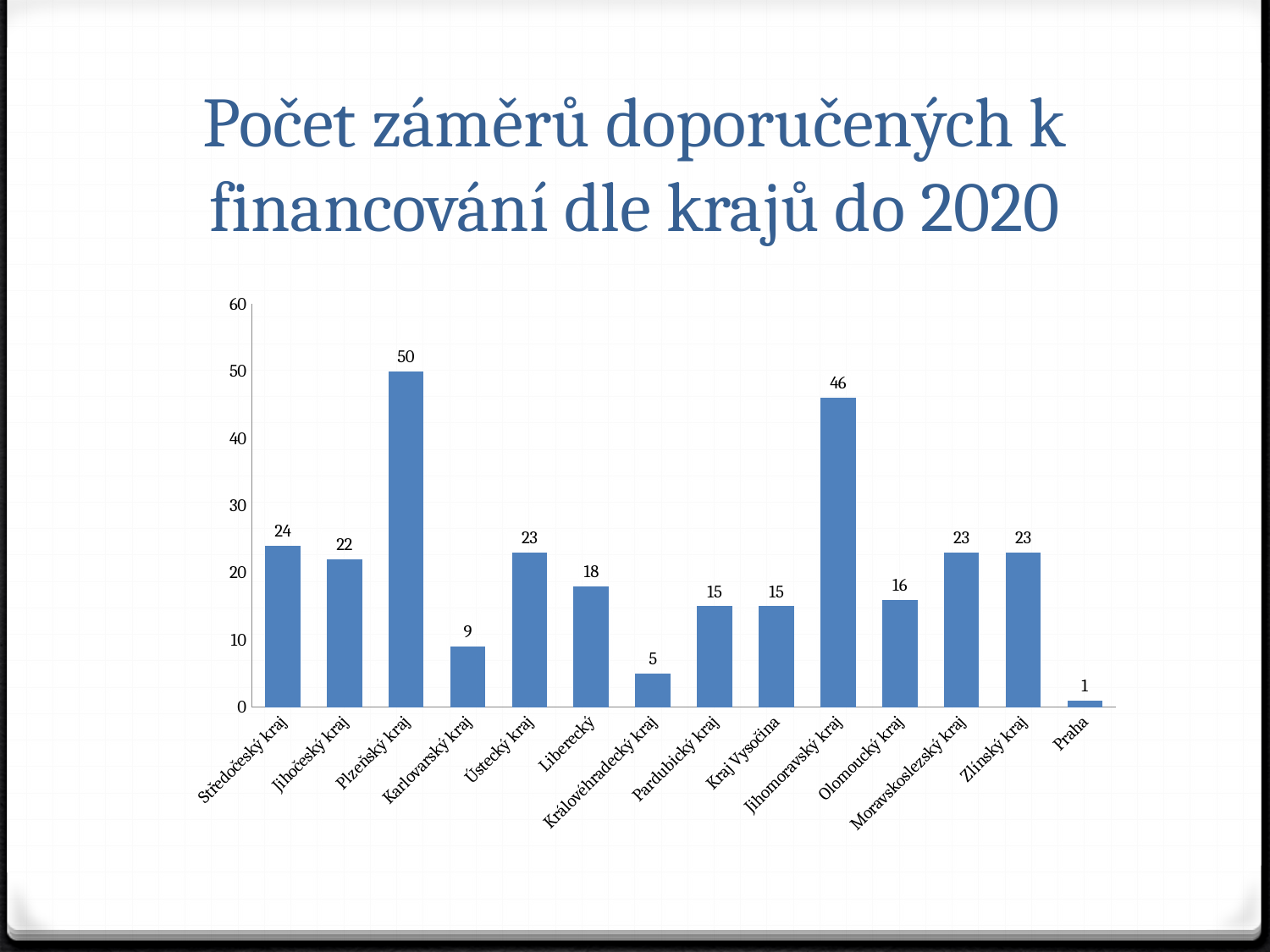
What is the value for Karlovarský kraj? 9 What is the difference between the values for Královéhradecký kraj and Praha? 4 What is the difference between the values for Plzeňský kraj and Jihomoravský kraj? 4 What is the value for Jihomoravský kraj? 46 What kind of chart is shown on the slide? bar chart Which category has the highest value? Plzeňský kraj Which category has the lowest value? Praha Is the value for Liberecký greater or less than 20? less What is the value for Plzeňský kraj? 50 How many categories are shown on the x axis? 14 Which is larger, the value for Středočeský kraj or the value for Jihočeský kraj? Středočeský kraj What is the title of the slide? Počet záměrů doporučených k financování dle krajů do 2020